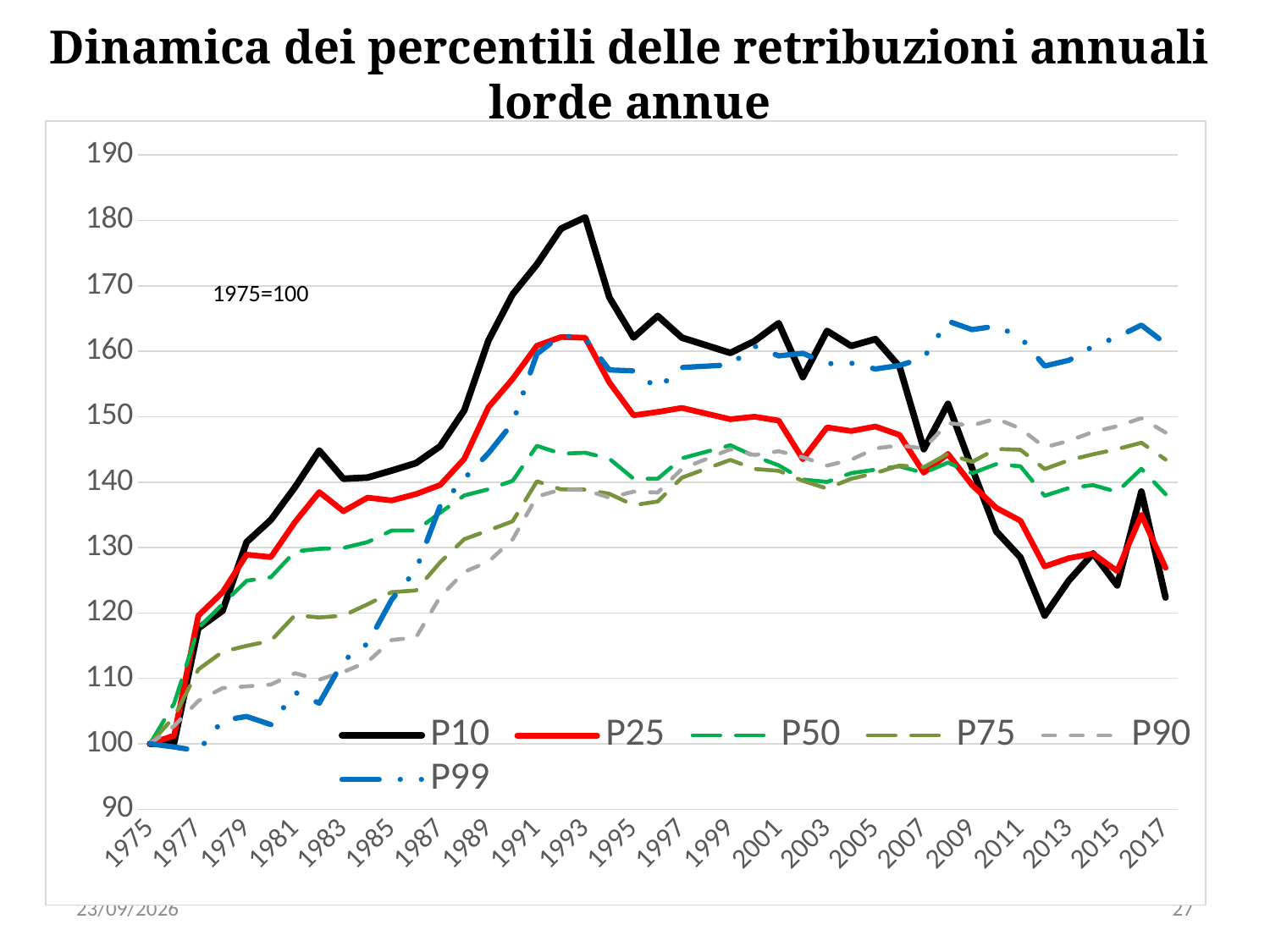
Which series has the lowest value in 2012? P10 Which series are listed in the legend? P10, P25, P50, P75, P90, P99 Is the value for P10 in 2012 greater or less than 130? less Which series has the highest value in 2017? P99 Is the value for P25 in 1993 greater or less than 150? greater Which series has the highest value in 1993? P10 How many series does the legend list? 6 What base-year note is printed inside the chart area? 1975=100 Is the value for P10 in 1993 greater or less than 170? greater What kind of chart is shown on the slide? line chart In 2017, which is larger: the value for P99 or the value for P10? P99